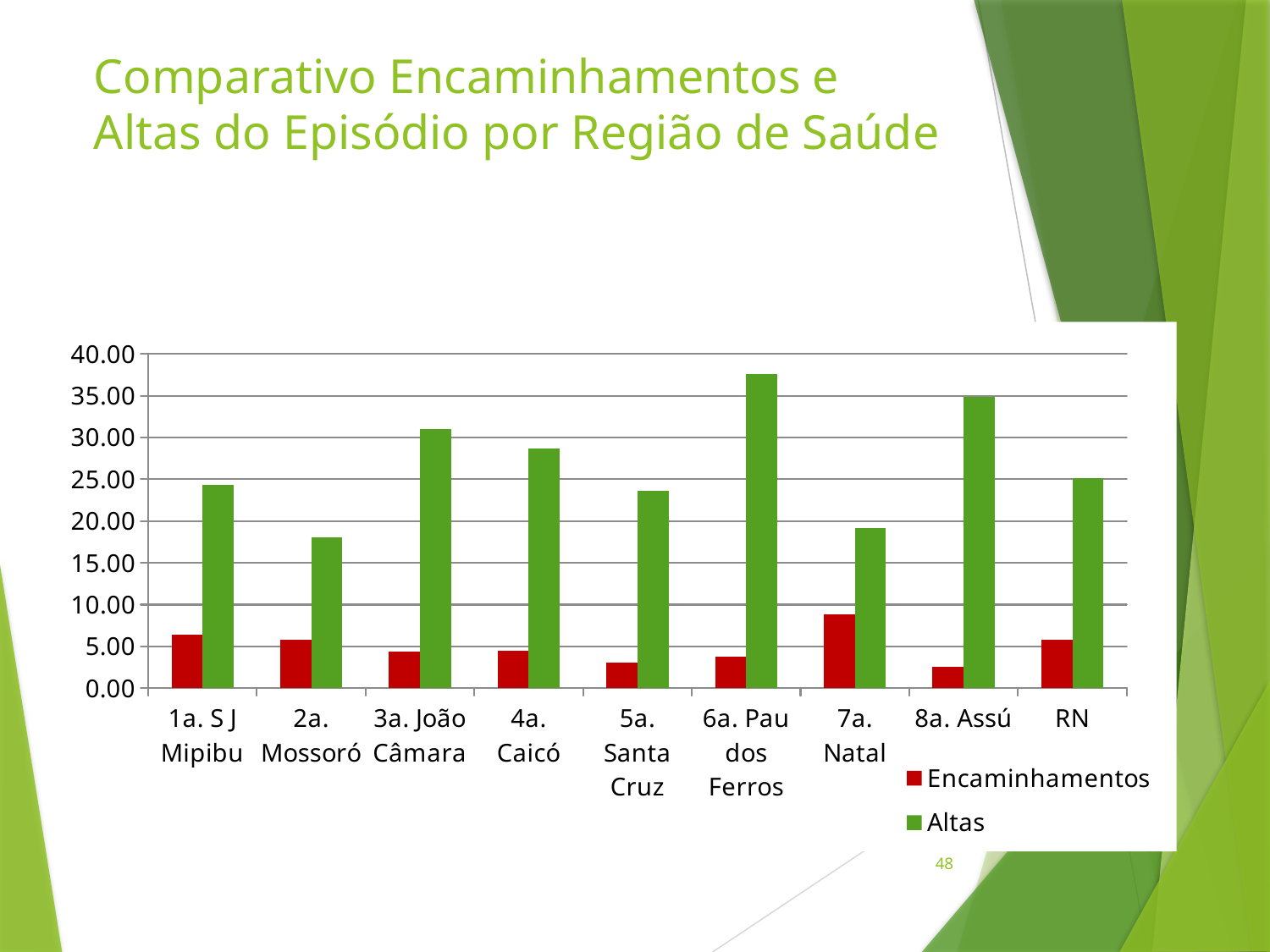
Which is larger, the Altas value for 3a. João Câmara or for 4a. Caicó? 3a. João Câmara Is the Encaminhamentos value for 7a. Natal greater or less than 5.00? greater Which category has the highest Encaminhamentos value? 7a. Natal How many categories are shown on the x axis? 9 How many series does the legend list? 2 Is the Altas value for 8a. Assú greater or less than 30.00? greater Is the Altas value for RN greater or less than 20.00? greater Which colour represents the Altas series? green What kind of chart is shown on the slide? bar chart Which category has the highest Altas value? 6a. Pau dos Ferros